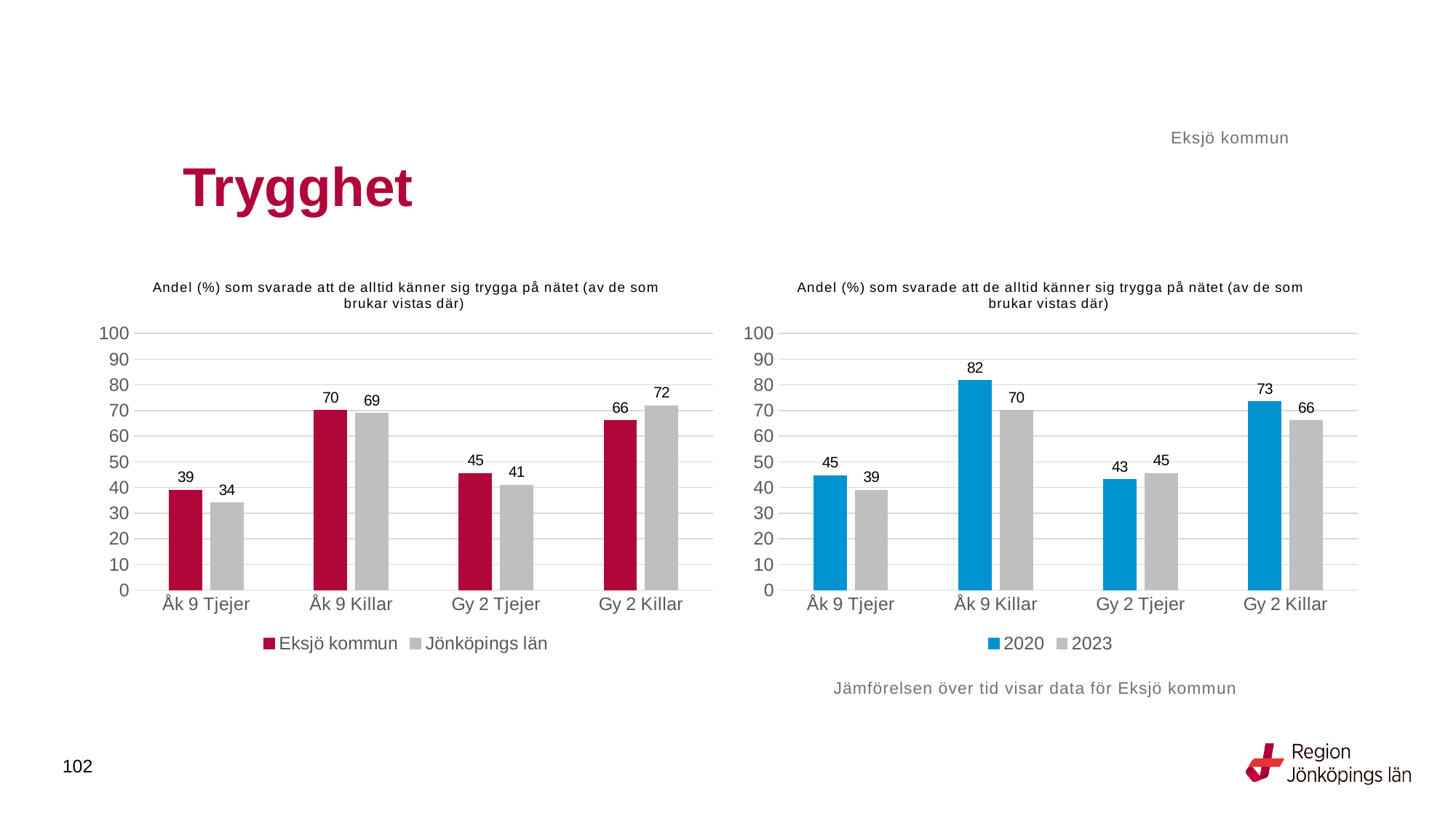
In the right chart, what is the difference between the 2020 and 2023 values for Åk 9 Killar? 12 In the left chart, what is the difference between Eksjö kommun and Jönköpings län for Åk 9 Tjejer? 5 In the left chart, which category has the highest value for Eksjö kommun? Åk 9 Killar In the left chart, what is the value for Eksjö kommun for Åk 9 Tjejer? 39 What kind of chart is the left chart? Bar chart In the right chart, what is the value for 2020 for Åk 9 Killar? 82 How many series does the legend of the right chart list? 2 In the right chart, which is larger for Gy 2 Tjejer: 2020 or 2023? 2023 In the left chart, which is larger for Gy 2 Killar: Eksjö kommun or Jönköpings län? Jönköpings län In the left chart, what is the value for Jönköpings län for Gy 2 Killar? 72 In the left chart, which category has the lowest value for Jönköpings län? Åk 9 Tjejer In the right chart, what is the value for 2023 for Gy 2 Tjejer? 45